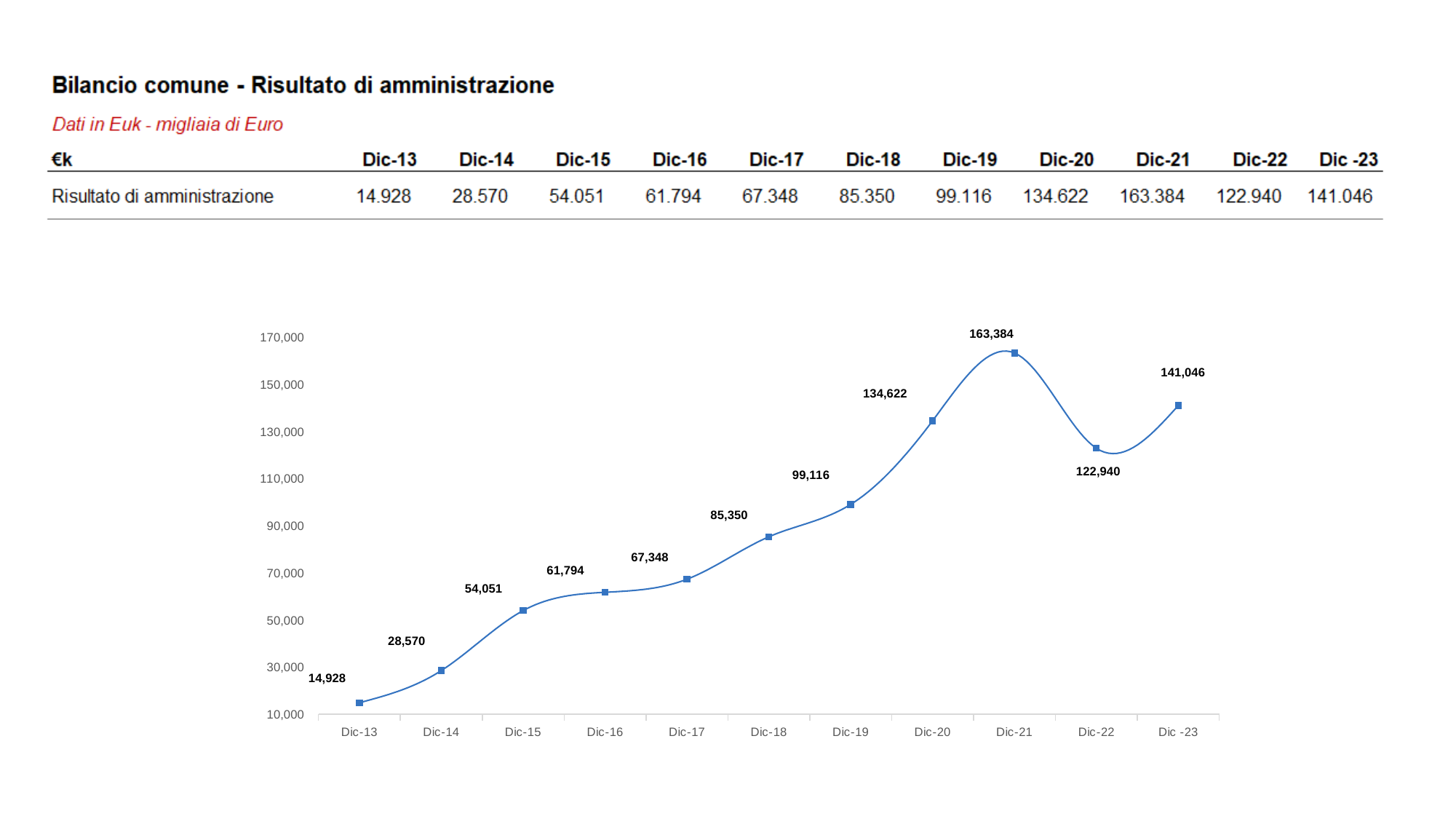
What is the title of the slide above the chart? Bilancio comune - Risultato di amministrazione What is the difference between the values for Dic-23 and Dic-22? 18,106 Does the value rise or fall from Dic-13 to Dic-21? rise What is the value for Dic-21 in the chart? 163,384 Which is larger, the value for Dic-20 or the value for Dic-23? Dic-23 What is the value for Dic-13 in the chart? 14,928 Which year has the lowest value in the chart? Dic-13 What is the difference between the values for Dic-21 and Dic-22? 40,444 Which year has the highest value in the chart? Dic-21 What is the value for Dic-22 in the chart? 122,940 What type of chart is shown on the slide? line chart How many data points are plotted in the chart? 11